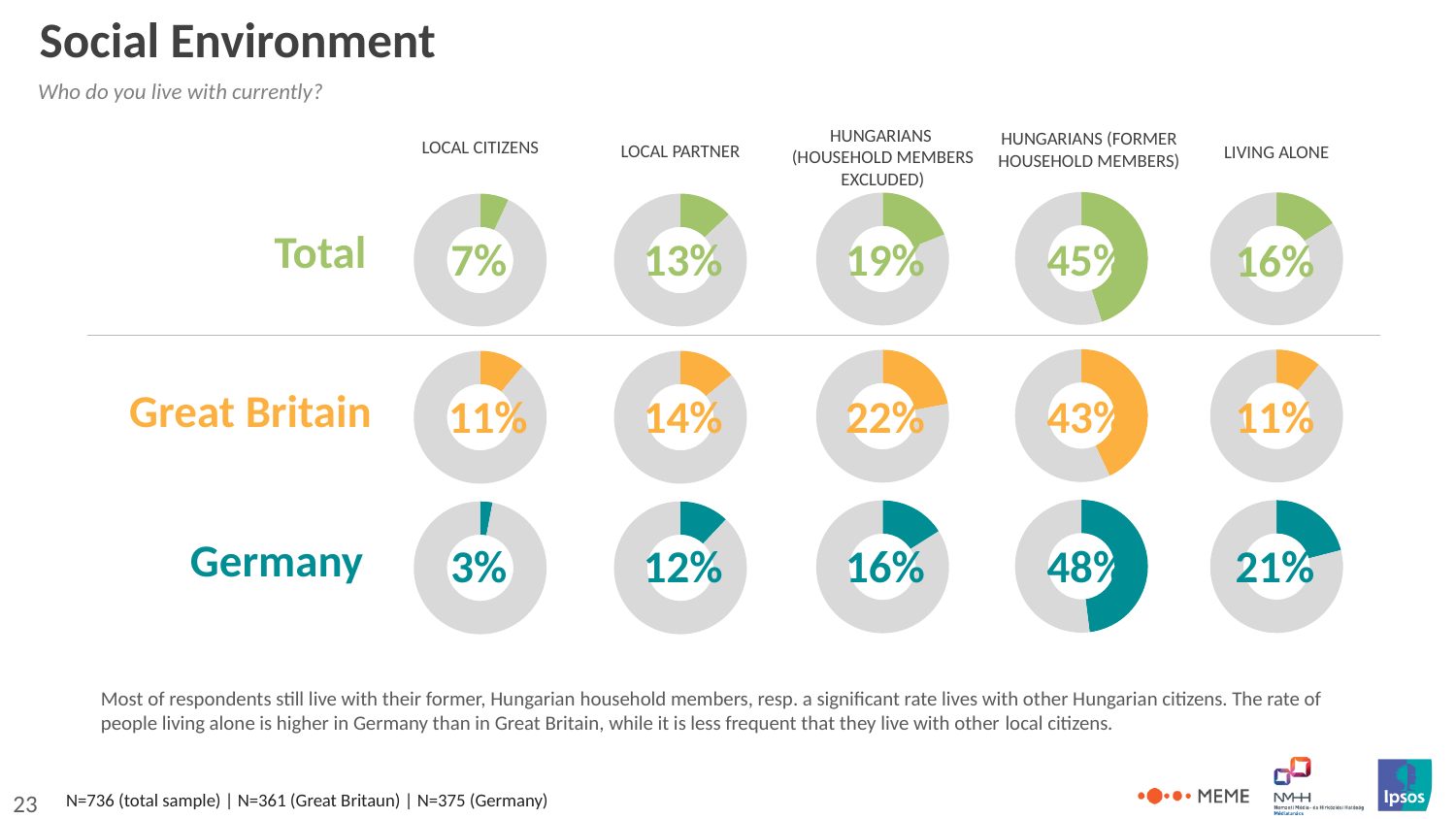
In the Germany row, what percentage is shown for Local citizens? 3% What colour are the donut charts in the Great Britain row? Orange What is the difference between the Germany and Great Britain percentages for Living alone? 10% What kind of chart is used to display the percentages on the slide? Donut (pie) chart In the Great Britain row, what percentage is shown for Hungarians (household members excluded)? 22% For Local citizens, which is larger: the Great Britain value or the Germany value? Great Britain For Hungarians (former household members), which is larger: the Total value or the Germany value? Germany How many rows of donut charts are shown on the slide? 3 In the Germany row, which category has the highest percentage? Hungarians (former household members) In the Total row, which category has the lowest percentage? Local citizens How many categories (columns of donut charts) are shown on the slide? 5 In the Total row, what percentage is shown for Living alone? 16%